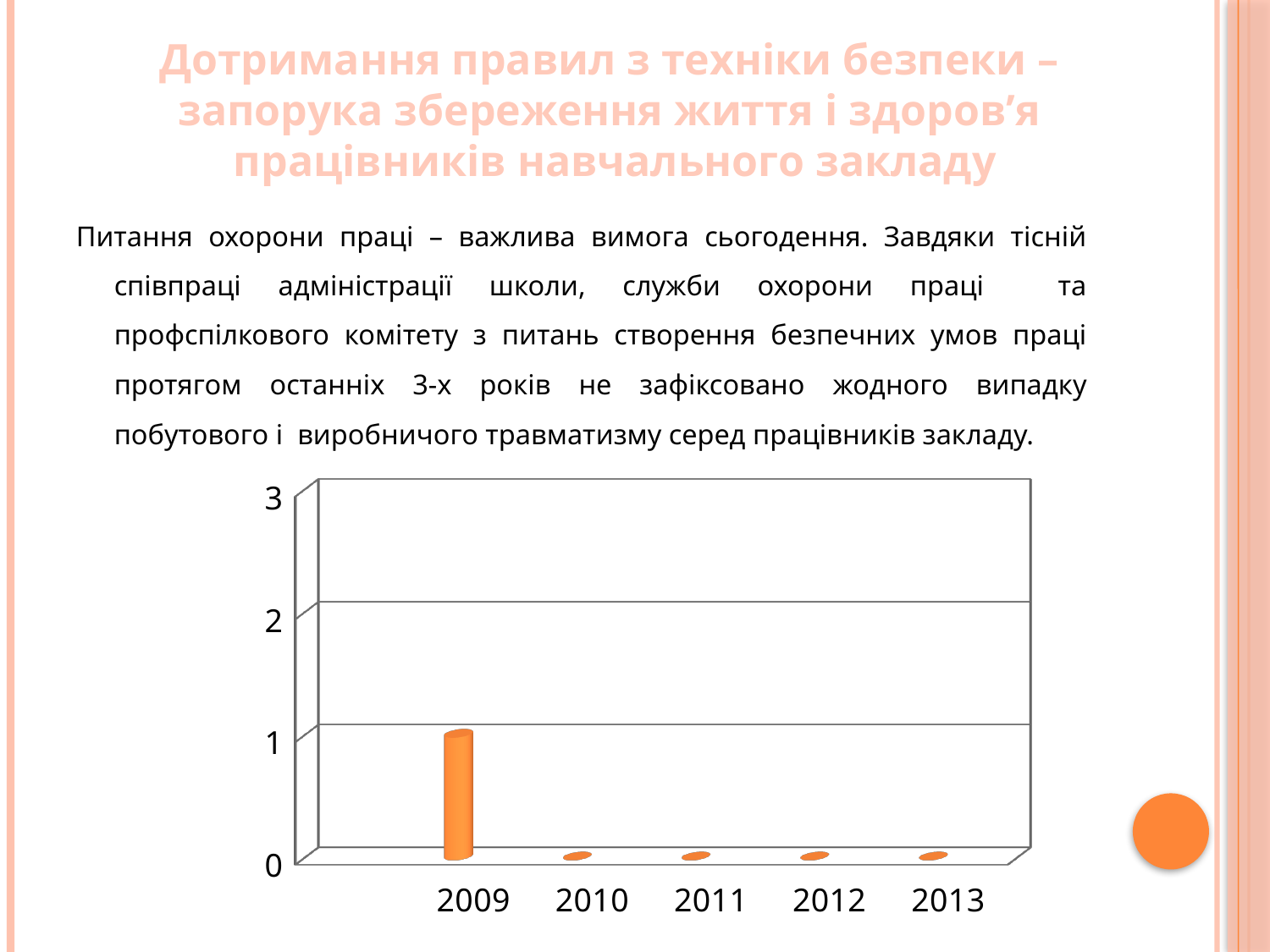
What colour are the bars in the chart? orange Which year has the highest value? 2009 How many years are shown on the x axis? 5 Do the values rise or fall from 2009 to 2013? fall Is the value for 2009 greater or less than 2? less How many years have a value of 0? 4 What is the difference between the values for 2009 and 2010? 1 What is the value for 2013? 0 What kind of chart is shown on the slide? bar chart Which is larger, the value for 2009 or the value for 2012? 2009 What is the value for 2010? 0 What is the value for 2009? 1